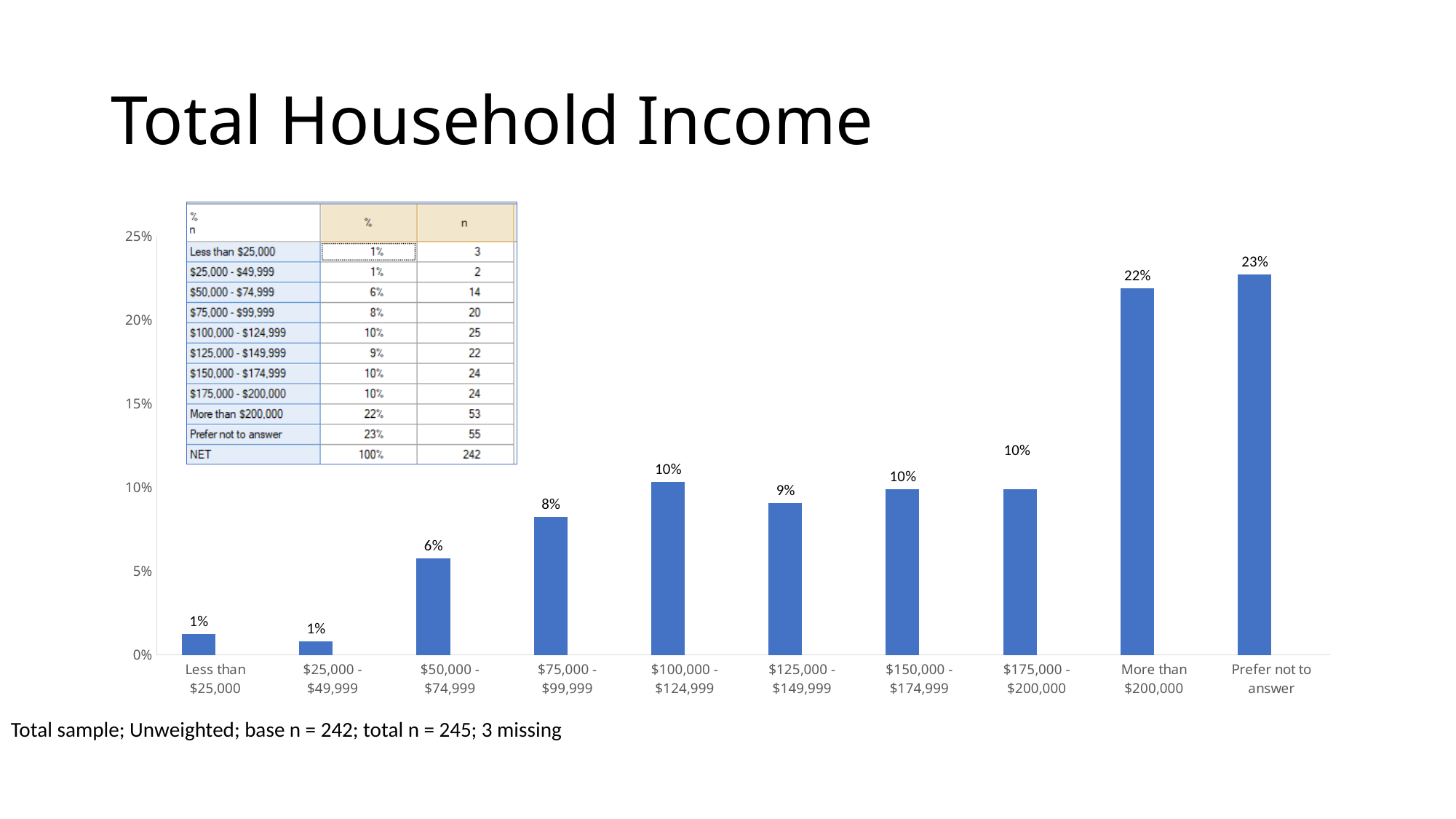
How many income categories are shown on the x axis of the chart? 10 What percentage of respondents chose 'Prefer not to answer'? 23% Which is larger: the value for '$125,000 - $149,999' or the value for '$100,000 - $124,999'? $100,000 - $124,999 What is the difference between the 'Prefer not to answer' value and the '$75,000 - $99,999' value? 15% What kind of chart is shown on the slide? Bar chart Which category has the highest value in the chart? Prefer not to answer What percentage of respondents reported a total household income of $50,000 - $74,999? 6% What is the value shown for the '$175,000 - $200,000' category? 10% Is the value for 'More than $200,000' greater or less than 20%? greater What is the highest value labelled on the y axis of the chart? 25% What is the title of the slide containing the chart? Total Household Income What is the value shown for the 'More than $200,000' category? 22%